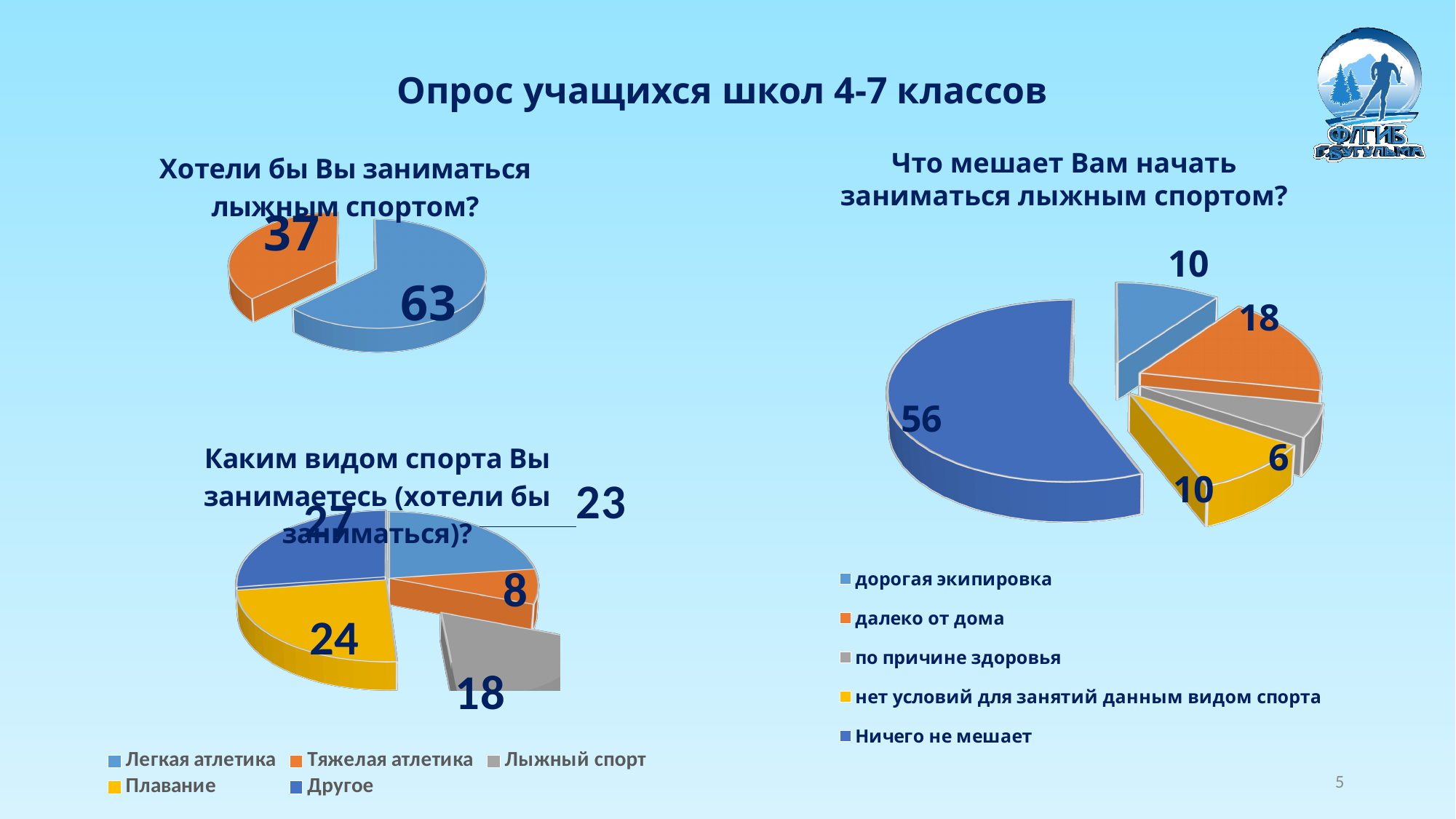
What kind of chart is used for 'Что мешает Вам начать заниматься лыжным спортом?'? Pie chart On the chart 'Каким видом спорта Вы занимаетесь (хотели бы заниматься)?', what is the value for 'Плавание'? 24 On the chart 'Что мешает Вам начать заниматься лыжным спортом?', which category has the smallest value? по причине здоровья On the chart 'Что мешает Вам начать заниматься лыжным спортом?', what is the value for 'Ничего не мешает'? 56 On the chart 'Хотели бы Вы заниматься лыжным спортом?', what is the value of the larger slice? 63 On the chart 'Что мешает Вам начать заниматься лыжным спортом?', how many categories does the legend list? 5 On the chart 'Что мешает Вам начать заниматься лыжным спортом?', what is the value for 'далеко от дома'? 18 On the chart 'Каким видом спорта Вы занимаетесь (хотели бы заниматься)?', what is the value for 'Лыжный спорт'? 18 On the chart 'Что мешает Вам начать заниматься лыжным спортом?', what is the difference between 'далеко от дома' and 'по причине здоровья'? 12 On the chart 'Каким видом спорта Вы занимаетесь (хотели бы заниматься)?', which category has the largest value? Другое On the chart 'Хотели бы Вы заниматься лыжным спортом?', how many slices does the pie have? 2 On the chart 'Каким видом спорта Вы занимаетесь (хотели бы заниматься)?', which is larger: 'Легкая атлетика' or 'Тяжелая атлетика'? Легкая атлетика